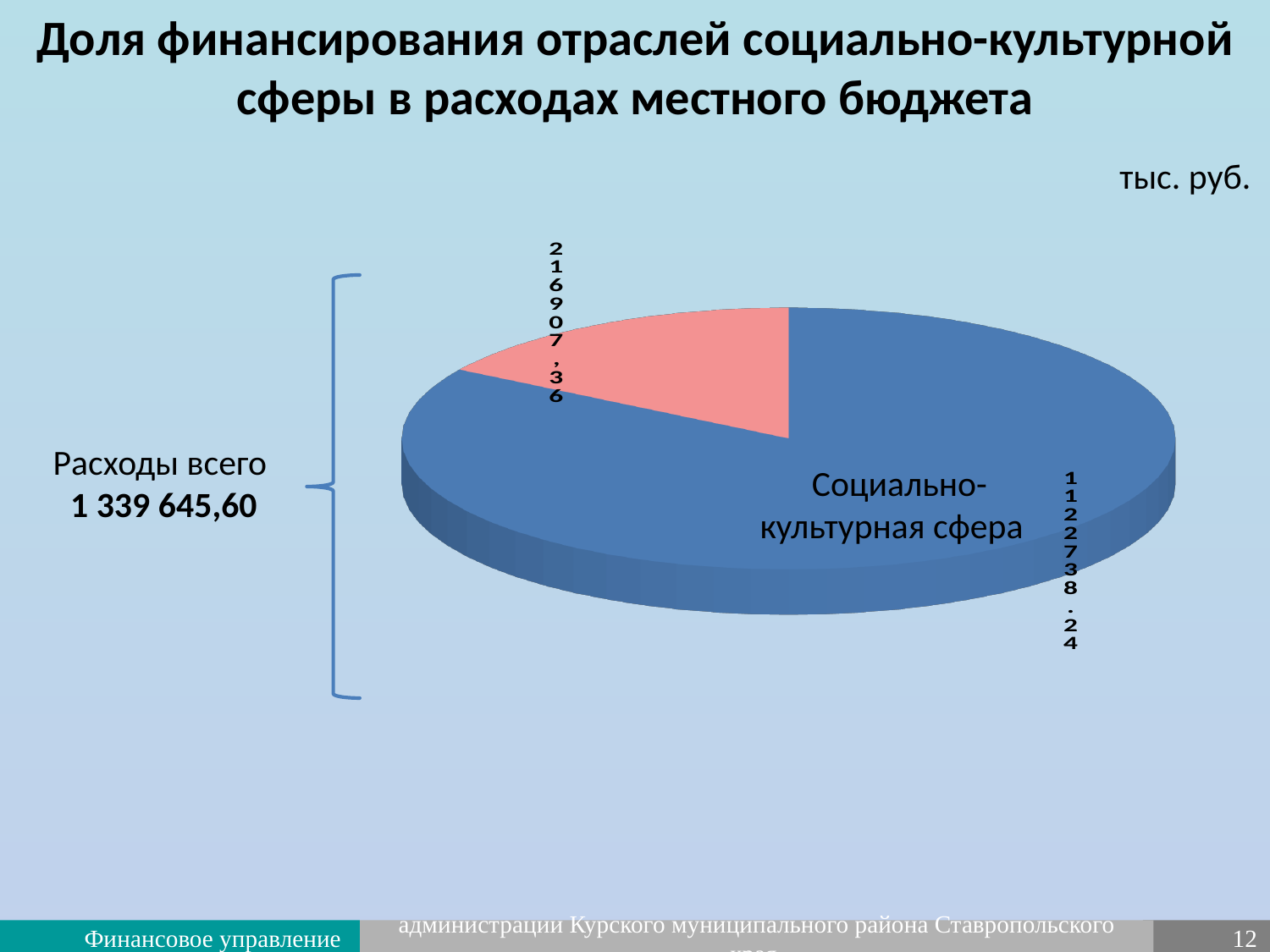
What is the difference between the Социально-культурная сфера value and the pink slice value? 905830,88 What share of the total expenditure (1 339 645,60) does the pink slice represent? 16.2% Is the value for Социально-культурная сфера greater or less than 1000000? greater What total expenditure (Расходы всего) is shown next to the pie chart? 1 339 645,60 What is the value shown on the pink slice of the pie chart? 216907,36 What kind of chart is shown on the slide? pie chart What share of the total expenditure (1 339 645,60) does the Социально-культурная сфера slice represent? 83.8% Which is larger: the Социально-культурная сфера slice or the pink slice? Социально-культурная сфера In what units are the values on the chart given? тыс. руб. How many slices does the pie chart have? 2 Which slice of the pie chart is the largest? Социально-культурная сфера What is the value shown for the Социально-культурная сфера slice? 1122738.24